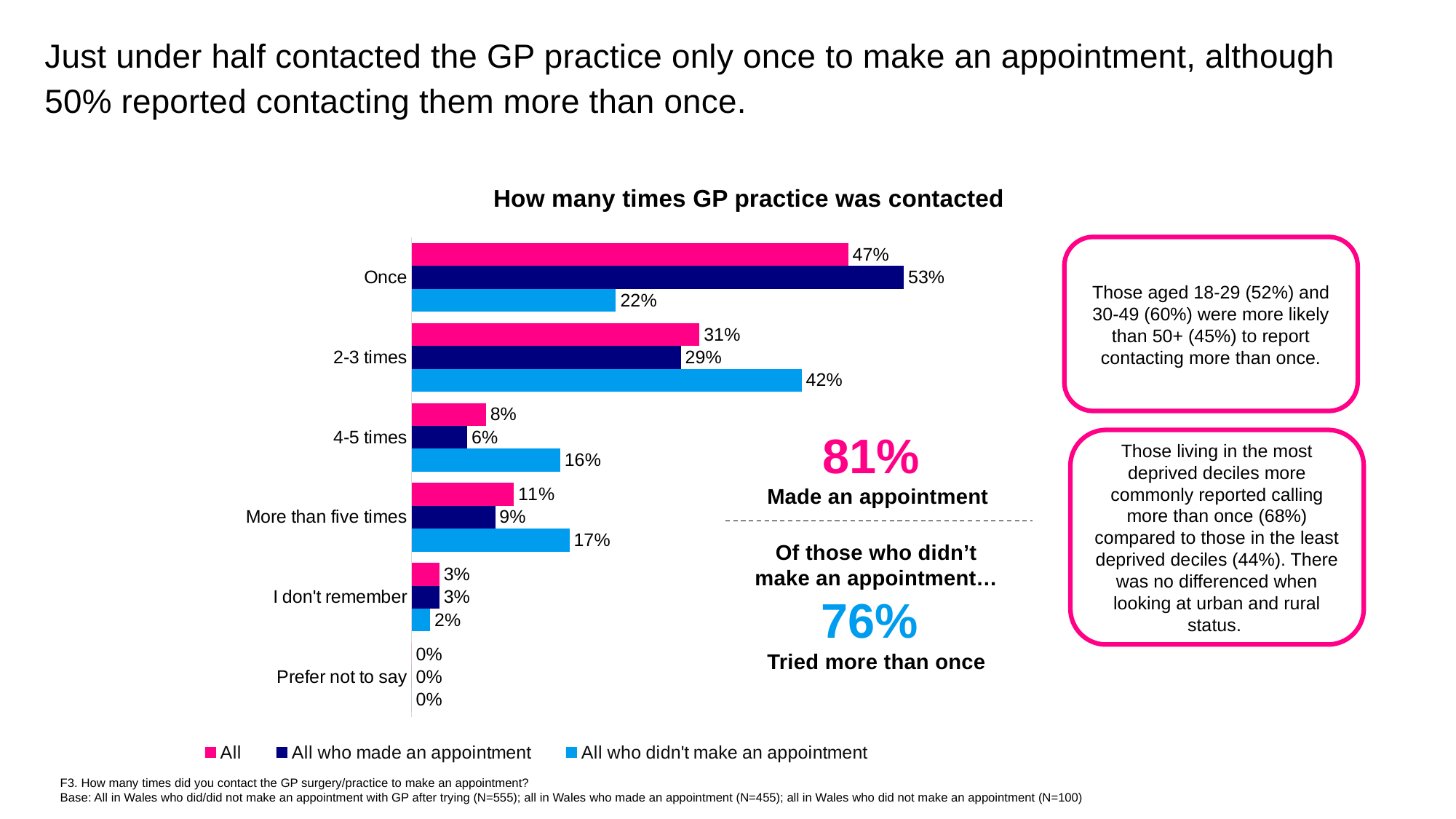
How many categories are shown on the chart? 6 Which category has the highest value in the 'All who made an appointment' series? Once What is the difference between the 'All who made an appointment' and 'All who didn't make an appointment' values for 'Once'? 31% What kind of chart is shown? Bar chart What is the title of the chart? How many times GP practice was contacted For 'More than five times', which series has the larger value: 'All' or 'All who didn't make an appointment'? All who didn't make an appointment What is the value for 'Once' in the 'All' series? 47% What is the value for '4-5 times' in the 'All who made an appointment' series? 6% How many series does the legend list? 3 What is the value for 'I don't remember' in the 'All who didn't make an appointment' series? 2% Which category has the highest value in the 'All who didn't make an appointment' series? 2-3 times What is the value for '2-3 times' in the 'All who didn't make an appointment' series? 42%